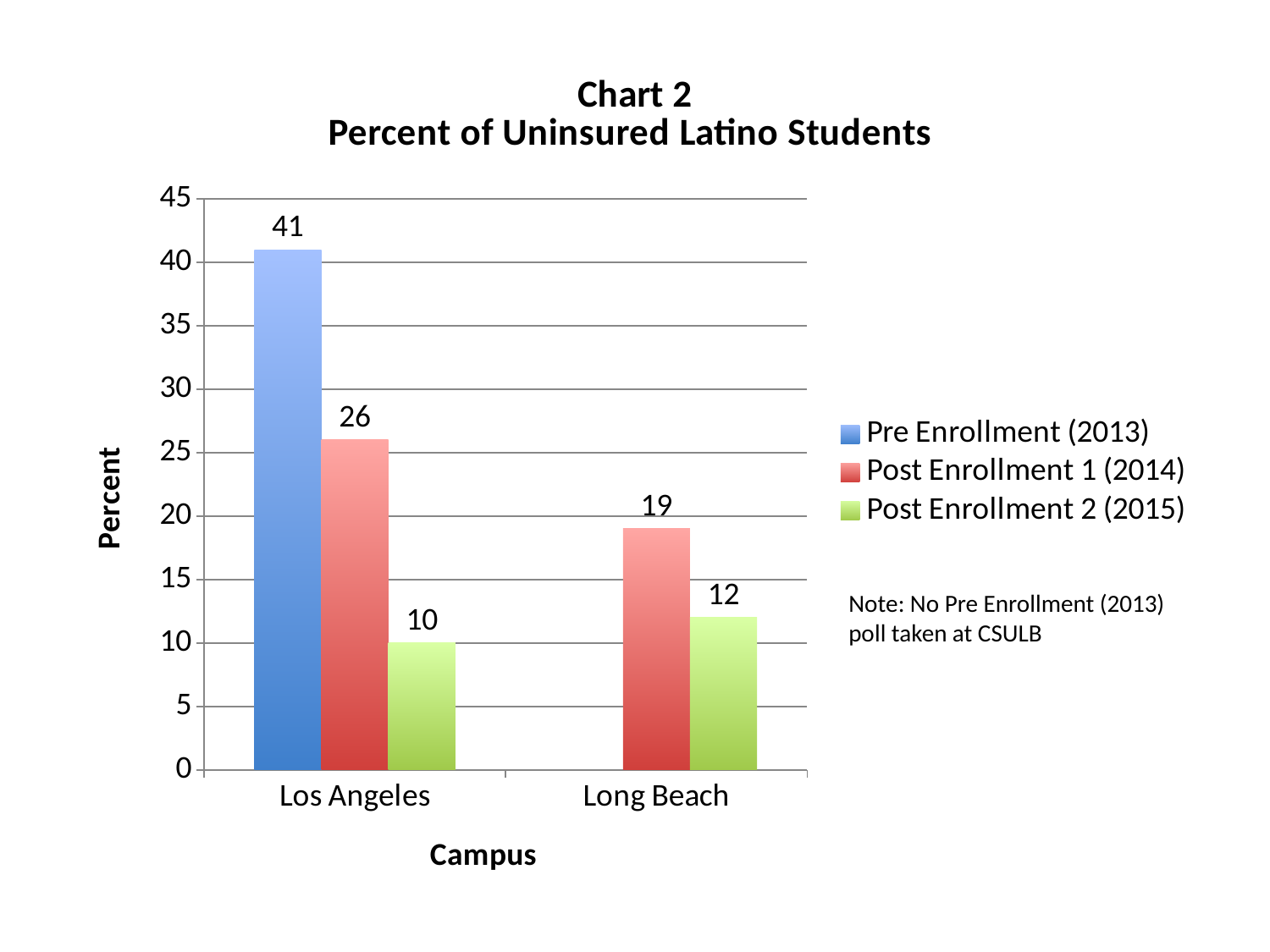
Which campus has the highest Post Enrollment 2 (2015) value? Long Beach What kind of chart is shown? Bar chart What is the Post Enrollment 1 (2014) value for Long Beach? 19 What is the difference between the Post Enrollment 1 (2014) values for Los Angeles and Long Beach? 7 Which is larger: the Post Enrollment 1 (2014) value for Los Angeles or the Post Enrollment 1 (2014) value for Long Beach? Los Angeles What is the Pre Enrollment (2013) value for Los Angeles? 41 What is the Post Enrollment 2 (2015) value for Los Angeles? 10 What is the difference between the Pre Enrollment (2013) and Post Enrollment 2 (2015) values for Los Angeles? 31 Do the values for Los Angeles rise or fall from Pre Enrollment (2013) to Post Enrollment 2 (2015)? Fall How many campuses are shown on the x axis? 2 How many series does the legend list? 3 Which series has the lowest value for Los Angeles? Post Enrollment 2 (2015)